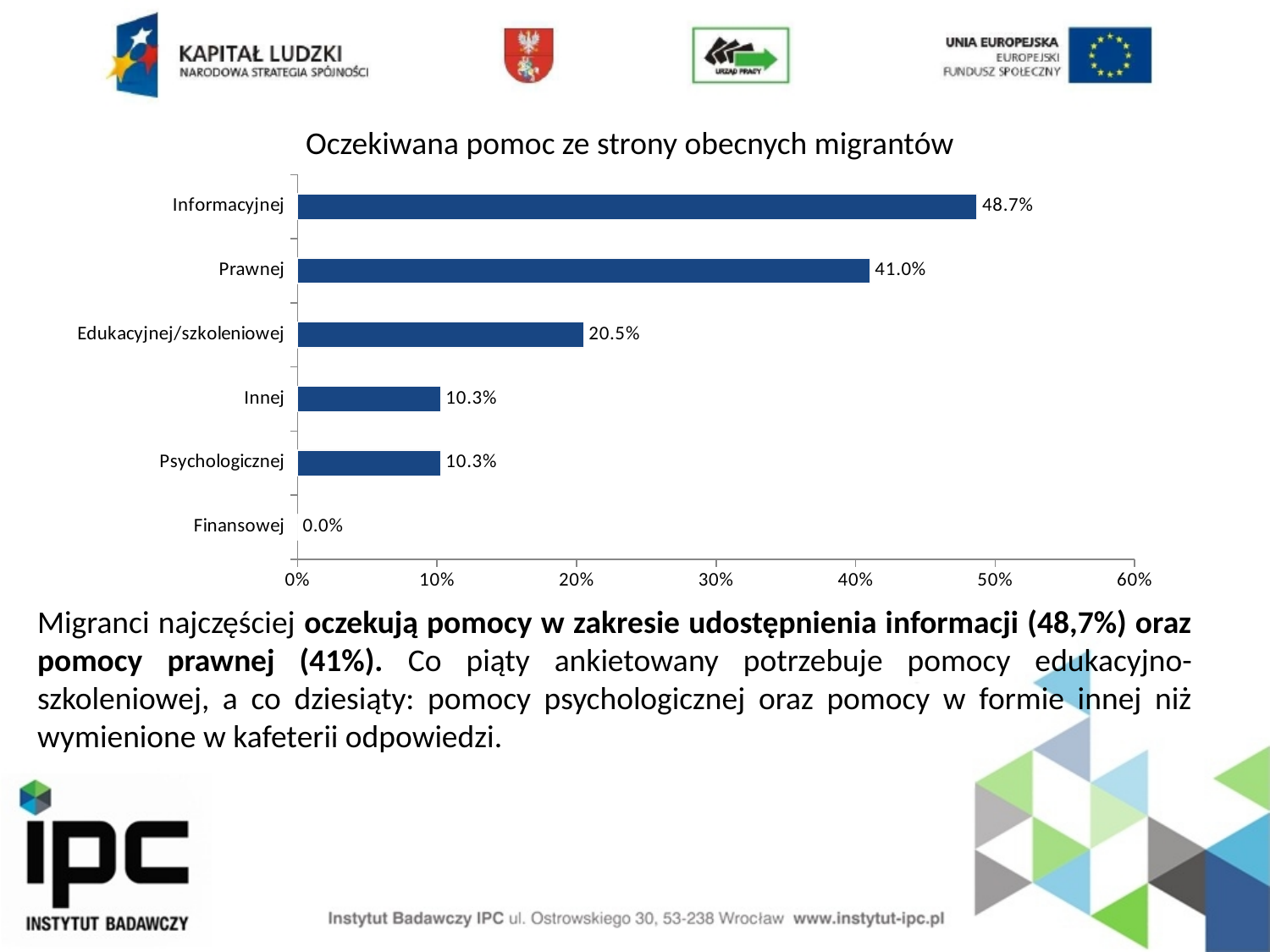
Which category has the lowest value? Finansowej Is the value for Edukacyjnej/szkoleniowej greater or less than 30%? less What is the value for Prawnej? 41.0% What is the value for Finansowej? 0.0% What is the difference between the values for Informacyjnej and Prawnej? 7.7% What is the value for Edukacyjnej/szkoleniowej? 20.5% How many categories are shown in the chart? 6 What kind of chart is shown on the slide? bar chart Which category has the highest value? Informacyjnej What is the title of the chart? Oczekiwana pomoc ze strony obecnych migrantów What is the value for Informacyjnej? 48.7% Which is larger, the value for Prawnej or the value for Edukacyjnej/szkoleniowej? Prawnej